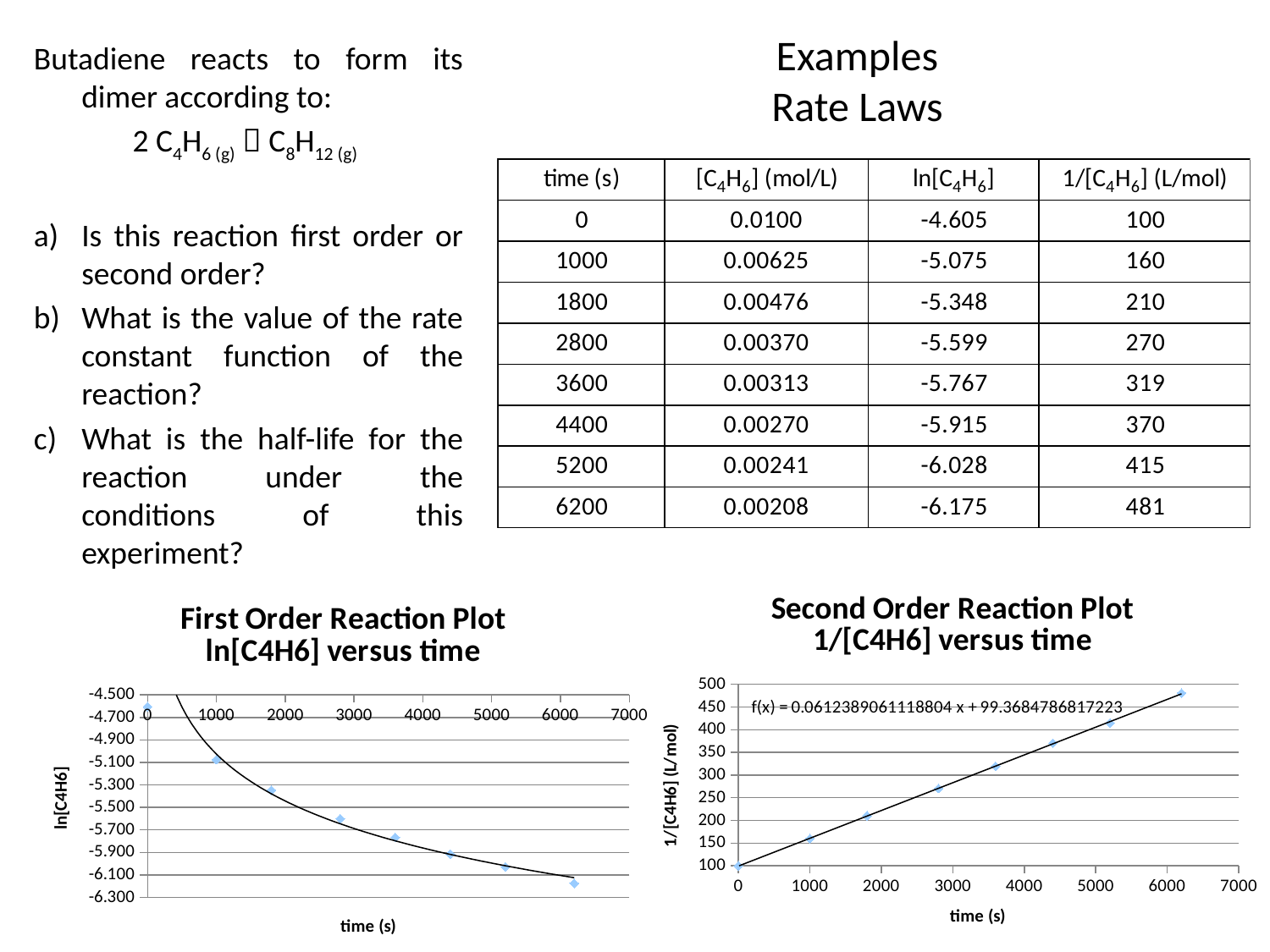
How many data points are plotted in the Second Order Reaction Plot? 8 In the First Order Reaction Plot, is the value at time 6200 s greater or less than -6.100? less In the Second Order Reaction Plot, what is the value of 1/[C4H6] at time 0? 100 What is the trendline equation shown on the Second Order Reaction Plot? f(x) = 0.0612389061118804 x + 99.3684786817223 What kind of chart is the First Order Reaction Plot? scatter chart In the First Order Reaction Plot, which time has the lowest ln[C4H6] value? 6200 In the First Order Reaction Plot, which is larger, the value at 1000 s or the value at 4400 s? 1000 s In the Second Order Reaction Plot, is the value at time 1000 s greater or less than 200? less In the Second Order Reaction Plot, is the value at time 6200 s greater or less than 450? greater In the First Order Reaction Plot, do the values rise or fall as time increases? fall In the Second Order Reaction Plot, what is the value of 1/[C4H6] at time 6200 s? 481 In the Second Order Reaction Plot, do the values rise or fall as time increases? rise